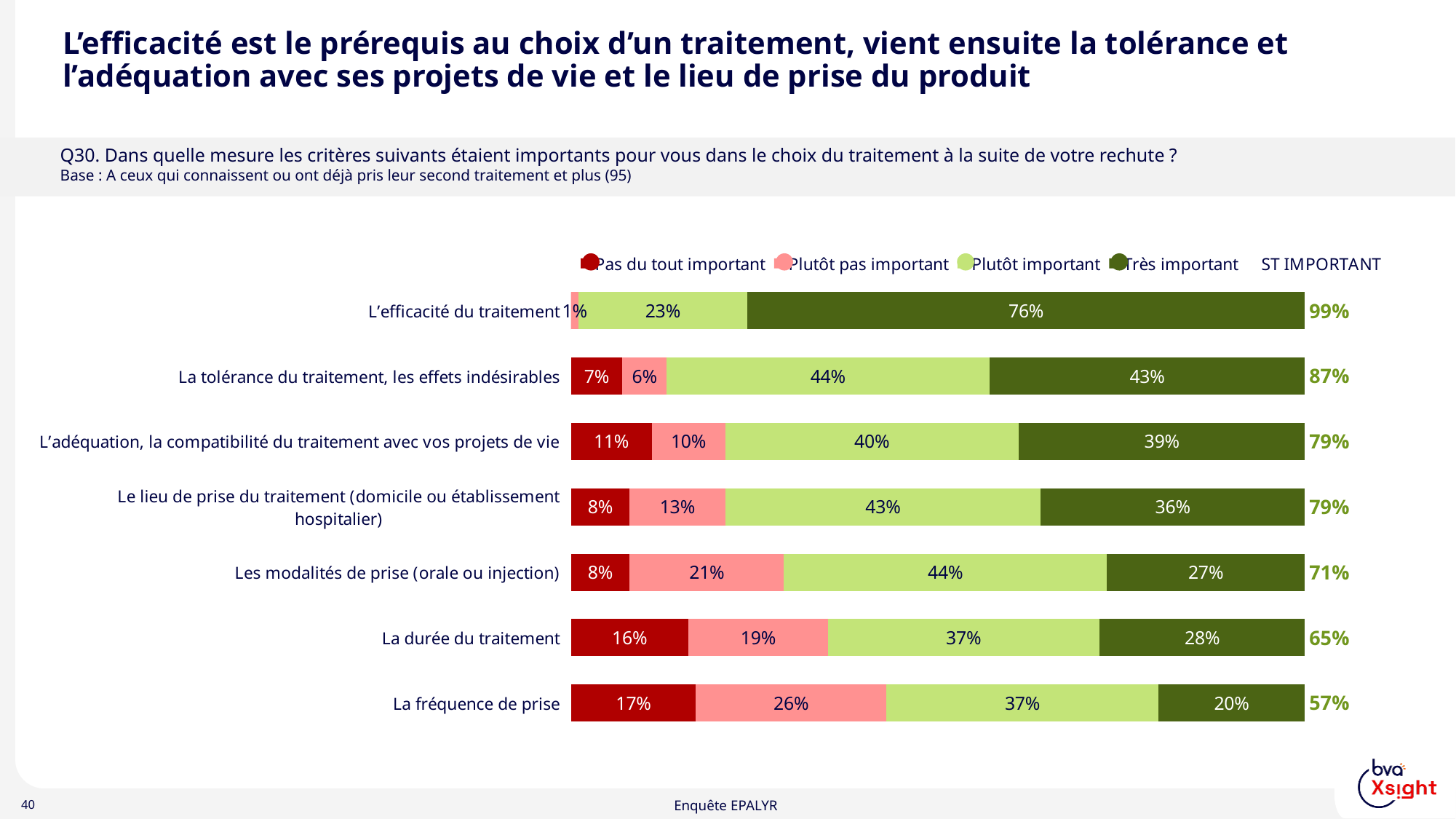
Which category has the highest 'Très important' value? L'efficacité du traitement Which is larger: the 'Très important' value for 'Le lieu de prise du traitement' or for 'Les modalités de prise'? Le lieu de prise du traitement How many series does the legend list? 4 What is the 'Pas du tout important' value for 'La fréquence de prise'? 17% What is the difference between the 'Plutôt important' values for 'La tolérance du traitement, les effets indésirables' and 'La durée du traitement'? 7% What is the 'Très important' value for 'L'efficacité du traitement'? 76% What is the combined total of 'Plutôt important' and 'Très important' for 'L'adéquation, la compatibilité du traitement avec vos projets de vie'? 79% Which category has the lowest 'ST IMPORTANT' value? La fréquence de prise What is the 'Plutôt pas important' value for 'Les modalités de prise (orale ou injection)'? 21% What kind of chart is shown on the slide? Stacked bar chart What is the 'ST IMPORTANT' value shown for 'La durée du traitement'? 65% How many categories (criteria) are shown in the chart? 7